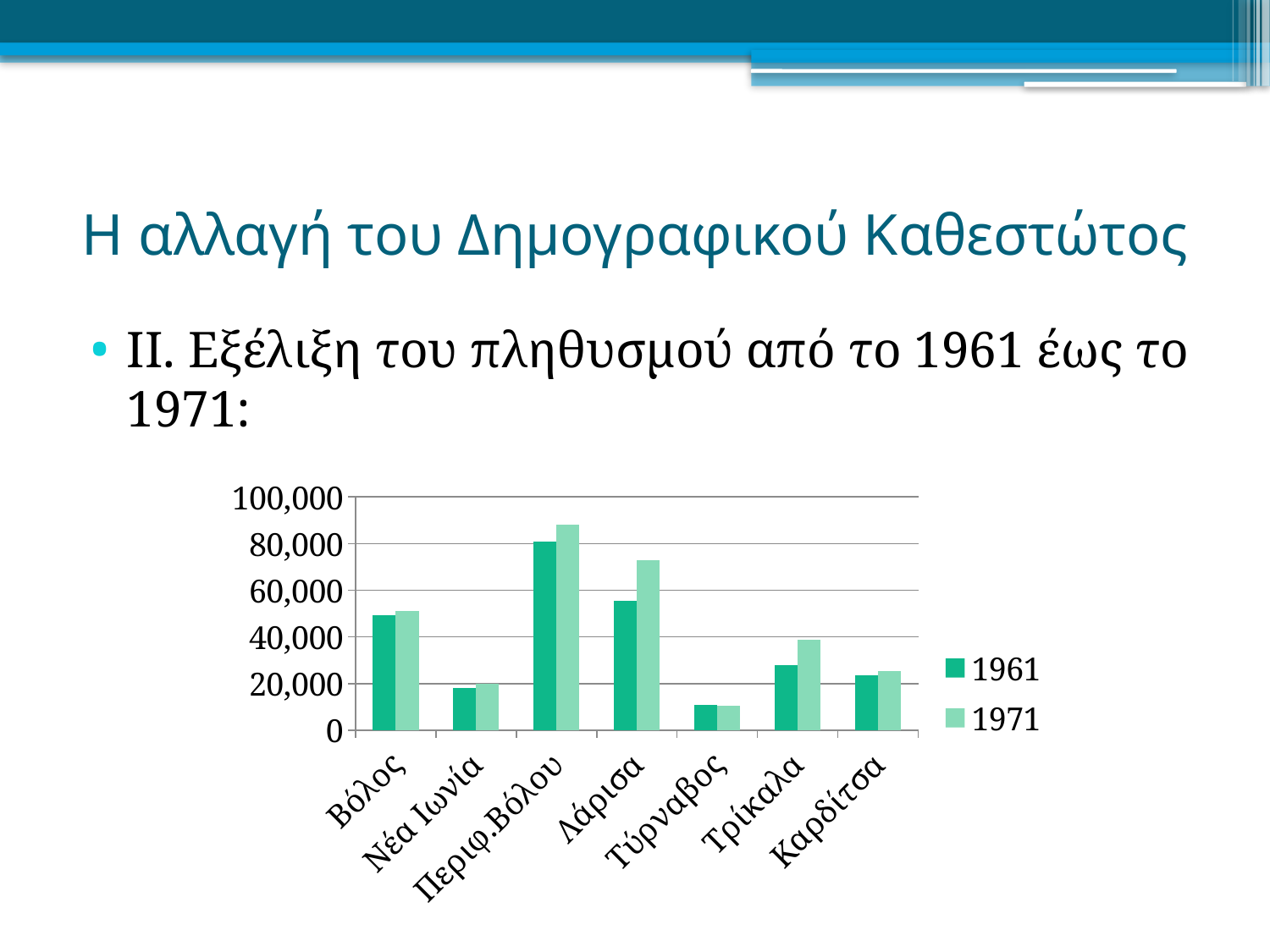
What are the two entries listed in the chart's legend? 1961 and 1971 Which category has the highest value for 1971? Περιφ.Βόλου For Λάρισα, which is larger: the 1961 value or the 1971 value? 1971 What kind of chart is shown on the slide? bar chart For Τρίκαλα, which is larger: the 1961 value or the 1971 value? 1971 Is the 1961 value for Τύρναβος greater or less than 20,000? less How many categories (places) are shown on the x axis of the chart? 7 Is the 1971 value for Περιφ.Βόλου greater or less than 80,000? greater Which category has the lowest value for 1971? Τύρναβος How many series does the chart's legend list? 2 Is the 1961 value for Λάρισα greater or less than 60,000? less Which category has the highest value for 1961? Περιφ.Βόλου